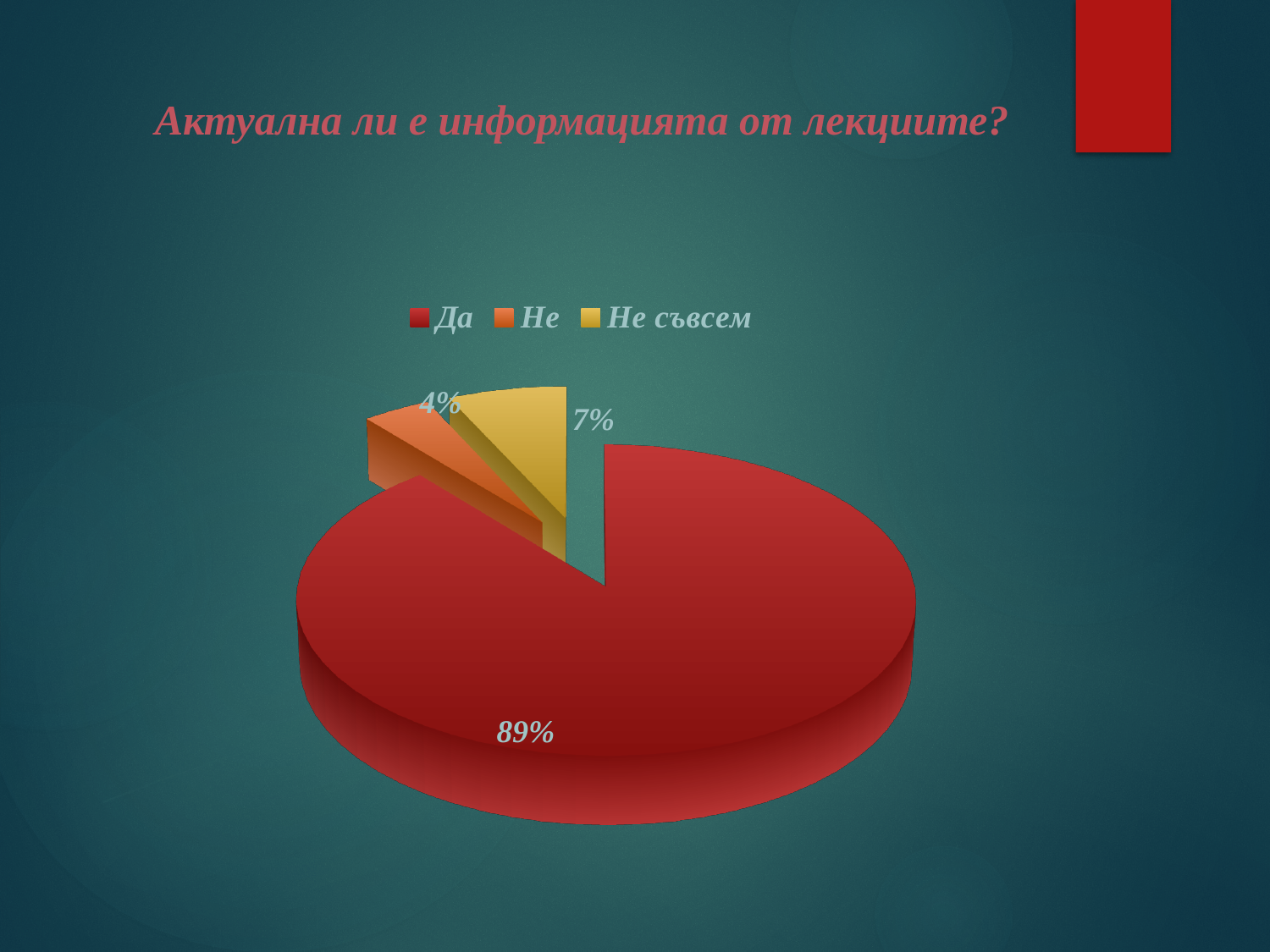
What is the title of the chart? Актуална ли е информацията от лекциите? What colour is the slice for "Да"? red Which category has the smallest share of the pie? Не What percentage is shown for "Да"? 89% What percentage is shown for "Не съвсем"? 7% What percentage is shown for "Не"? 4% How many categories does the legend list? 3 Which category has the largest share of the pie? Да What is the difference in percentage points between "Да" and "Не съвсем"? 82 Which is larger, the share for "Не" or the share for "Не съвсем"? Не съвсем What kind of chart is shown on the slide? pie chart How many slices does the pie chart have? 3